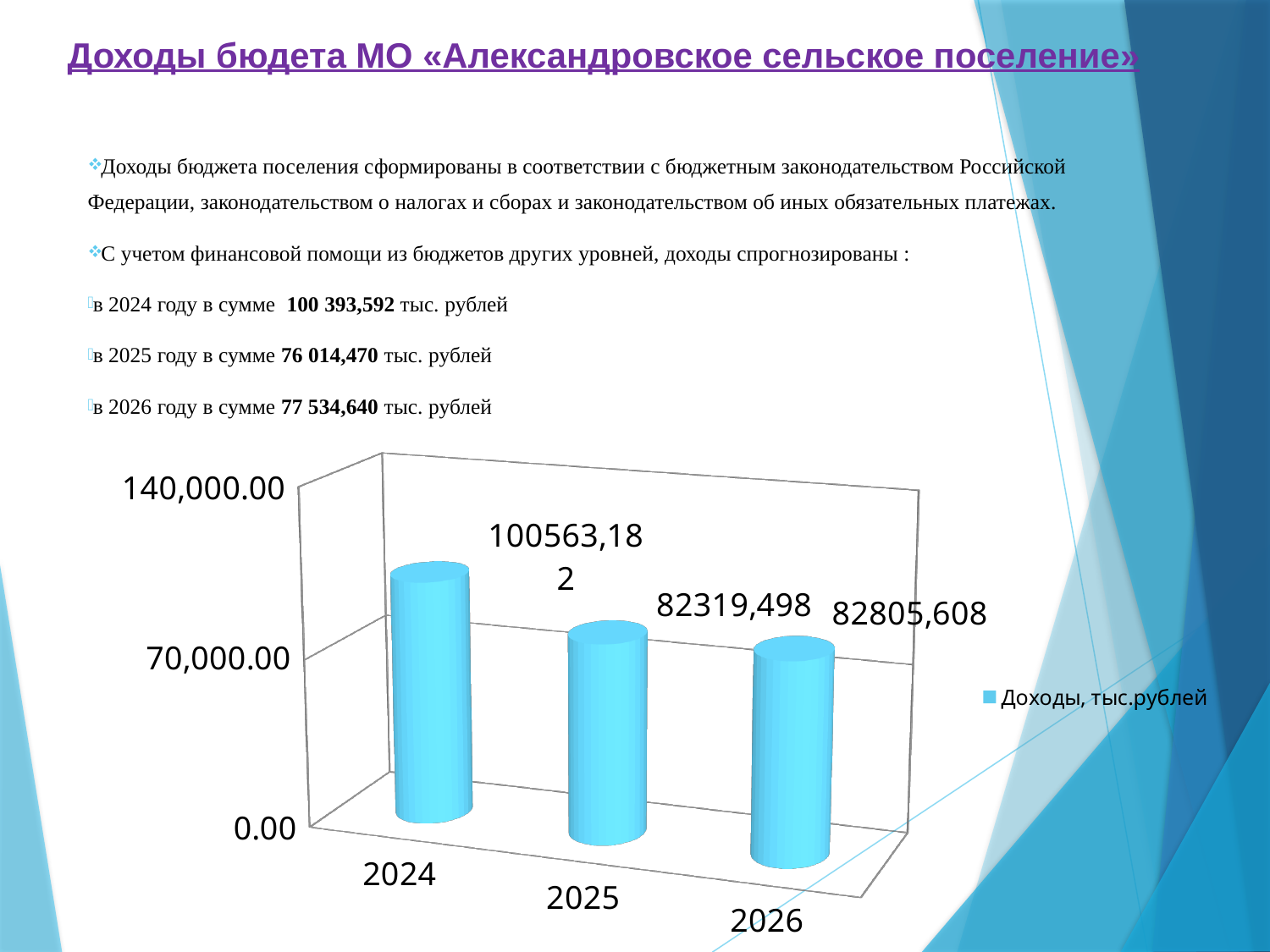
What is the legend entry of the chart? Доходы, тыс.рублей What is the difference between the values for 2024 and 2025 in the chart? 18243,684 What is the value shown for 2026 in the chart? 82805,608 What is the value shown for 2024 in the chart? 100563,182 What kind of chart is shown on the slide? bar chart Which is larger in the chart, the value for 2025 or the value for 2026? 2026 Which year has the highest value in the chart? 2024 Is the value for 2024 greater or less than 70,000.00? greater How many series does the chart legend list? 1 How many years are shown on the x axis of the chart? 3 What is the value shown for 2025 in the chart? 82319,498 Which year has the lowest value in the chart? 2025